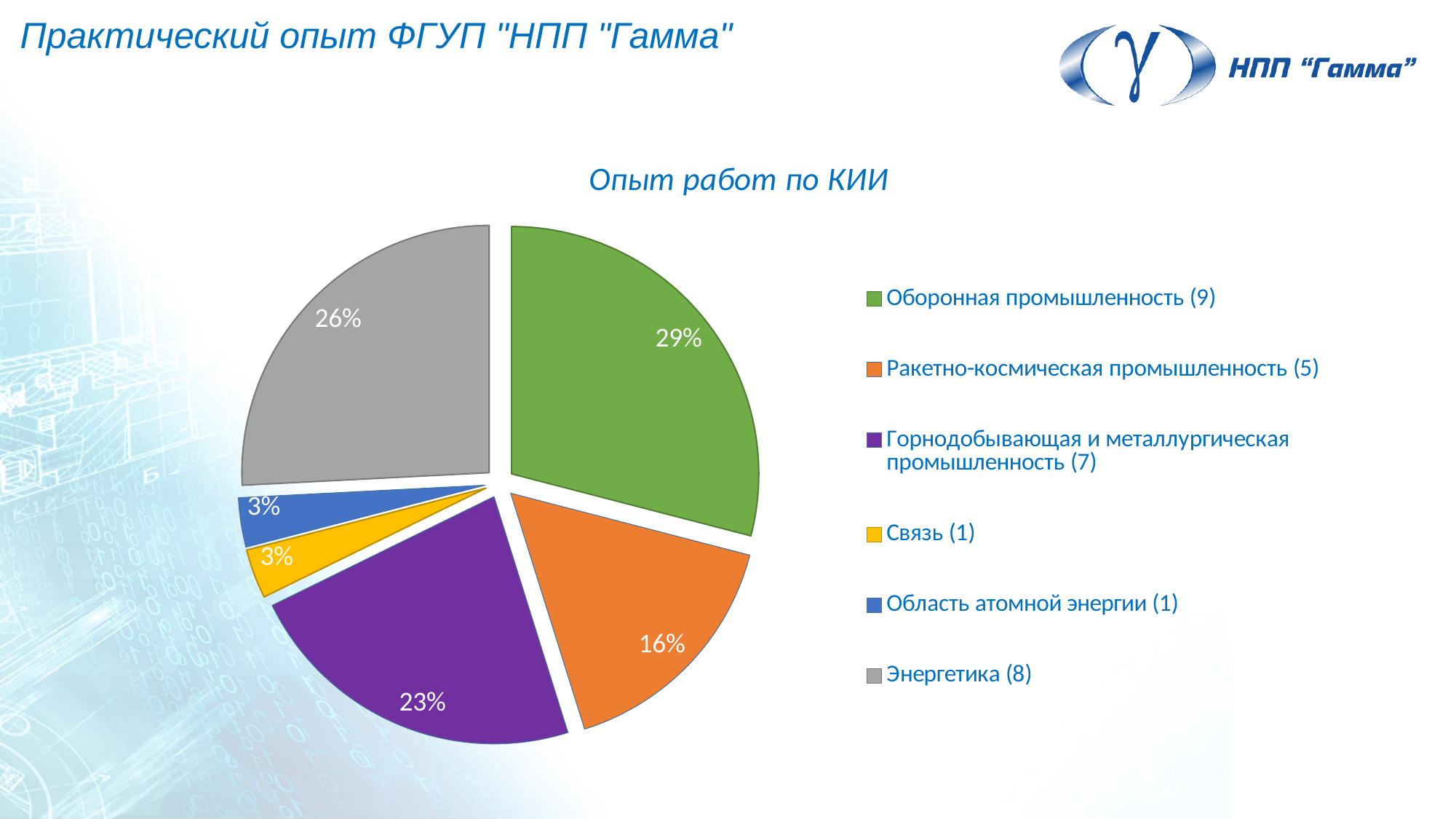
What share of the pie does Энергетика (8) take? 26% What share of the pie does Оборонная промышленность (9) take? 29% What share of the pie does Горнодобывающая и металлургическая промышленность (7) take? 23% What is the difference in percentage points between the Оборонная промышленность (9) slice and the Ракетно-космическая промышленность (5) slice? 13 What colour is the slice for Область атомной энергии (1)? blue Which category has the largest slice of the pie? Оборонная промышленность (9) What kind of chart is shown on the slide? pie chart Which slice is larger: Энергетика (8) or Горнодобывающая и металлургическая промышленность (7)? Энергетика (8) What is the title of the chart? Опыт работ по КИИ How many slices does the pie chart have? 6